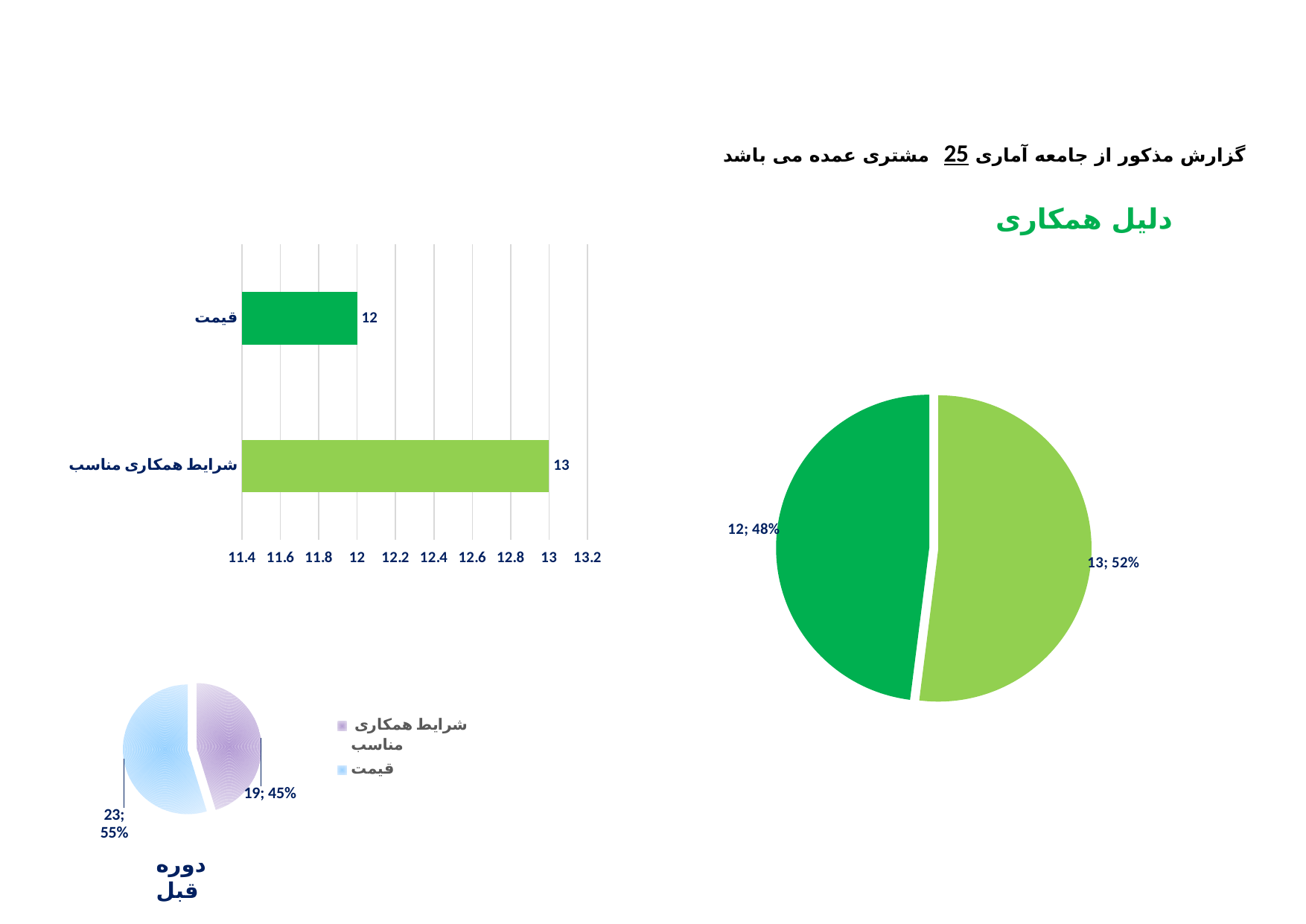
In the small pie chart on the bottom left labeled دوره قبل, what is the value and share of the قیمت slice? 23; 55% In the bar chart on the top left, which category has the highest value? شرایط همکاری مناسب In the small pie chart on the bottom left labeled دوره قبل, what is the value and share of the شرایط همکاری مناسب slice? 19; 45% In the large pie chart on the right titled دلیل همکاری, what share does the slice with value 12 have? 48% In the bar chart on the top left, what is the value for قیمت? 12 What kind of chart is shown on the top left of the slide? bar chart How many entries does the legend of the small pie chart on the bottom left list? 2 In the bar chart on the top left, which category has the lowest value? قیمت In the bar chart on the top left, what is the difference between the values for شرایط همکاری مناسب and قیمت? 1 How many categories does the bar chart on the top left show? 2 In the bar chart on the top left, what is the value for شرایط همکاری مناسب? 13 In the large pie chart on the right titled دلیل همکاری, what share does the slice with value 13 have? 52%